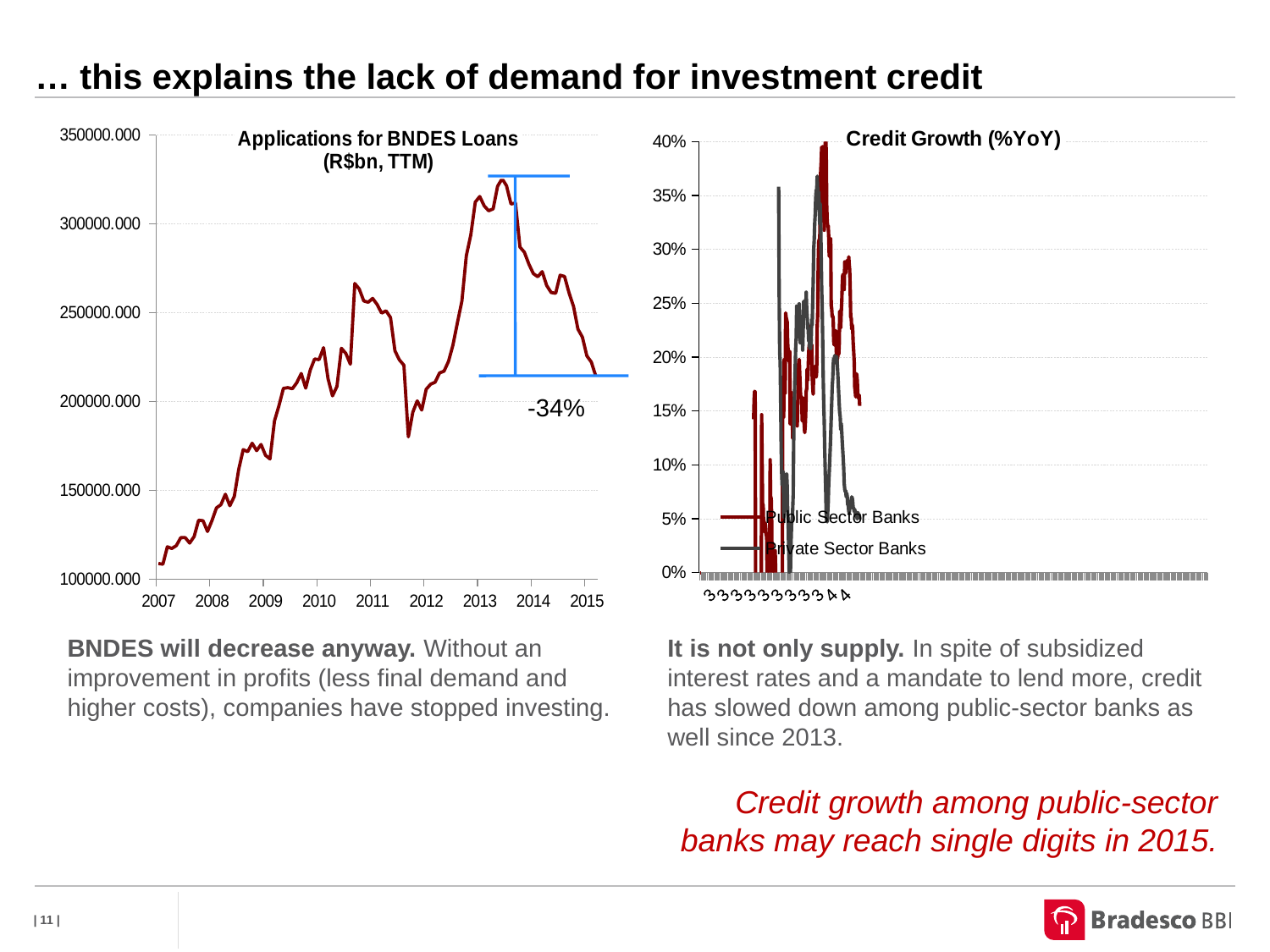
In the 'Applications for BNDES Loans (R$bn, TTM)' chart, do the values generally rise or fall between 2007 and 2013? Rise In the 'Applications for BNDES Loans (R$bn, TTM)' chart, is the value at the start of 2007 greater or less than 150000.000? less In the 'Credit Growth (%YoY)' chart, is the highest value of the Public Sector Banks series greater or less than 30%? greater In the 'Credit Growth (%YoY)' chart, is the final value of the Private Sector Banks series greater or less than 10%? less In the 'Applications for BNDES Loans (R$bn, TTM)' chart, do the values rise or fall between 2013 and 2015? Fall What kind of chart is the 'Credit Growth (%YoY)' chart? Line chart In the 'Credit Growth (%YoY)' chart, which series is drawn in dark red? Public Sector Banks In the 'Applications for BNDES Loans (R$bn, TTM)' chart, how many year labels are shown on the x axis? 9 In the 'Credit Growth (%YoY)' chart, how many series does the legend list? 2 What kind of chart is the 'Applications for BNDES Loans (R$bn, TTM)' chart? Line chart In the 'Applications for BNDES Loans (R$bn, TTM)' chart, what percentage change is annotated next to the blue bracket? -34%